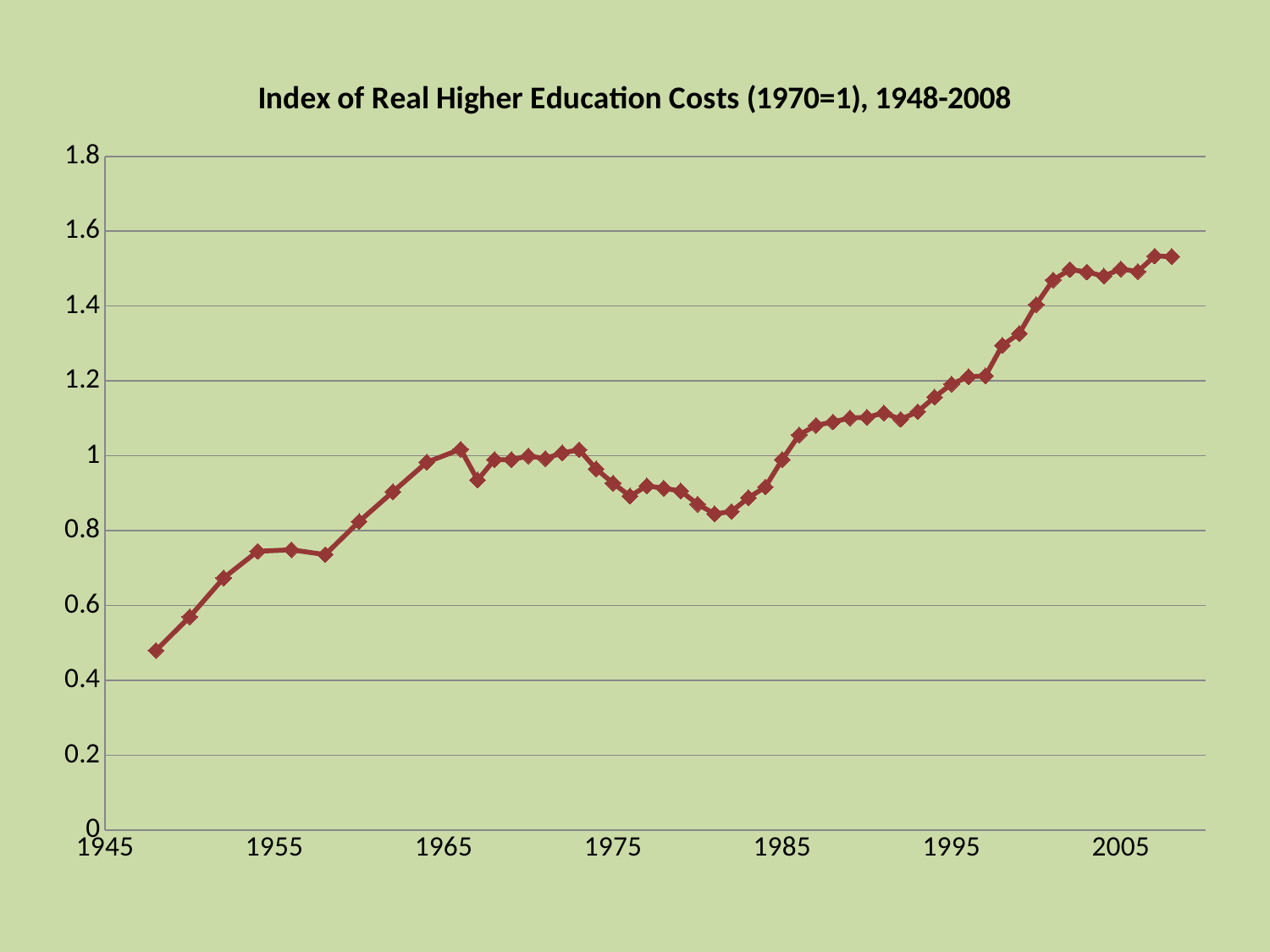
What is the title of the chart? Index of Real Higher Education Costs (1970=1), 1948-2008 Which year has the larger index value, 1948 or 2008? 2008 Is the value of the index in 2008 greater or less than 1.4? greater Does the index generally rise or fall from 1948 to 2008? rise Does the index rise or fall between 1973 and 1981? fall In which year is the index at its lowest value? 1948 Is the value of the index in 1948 greater or less than 0.6? less What is the value of the index in 1970? 1 What kind of chart is shown on the slide? line chart Is the value of the index in 1995 greater or less than 1? greater